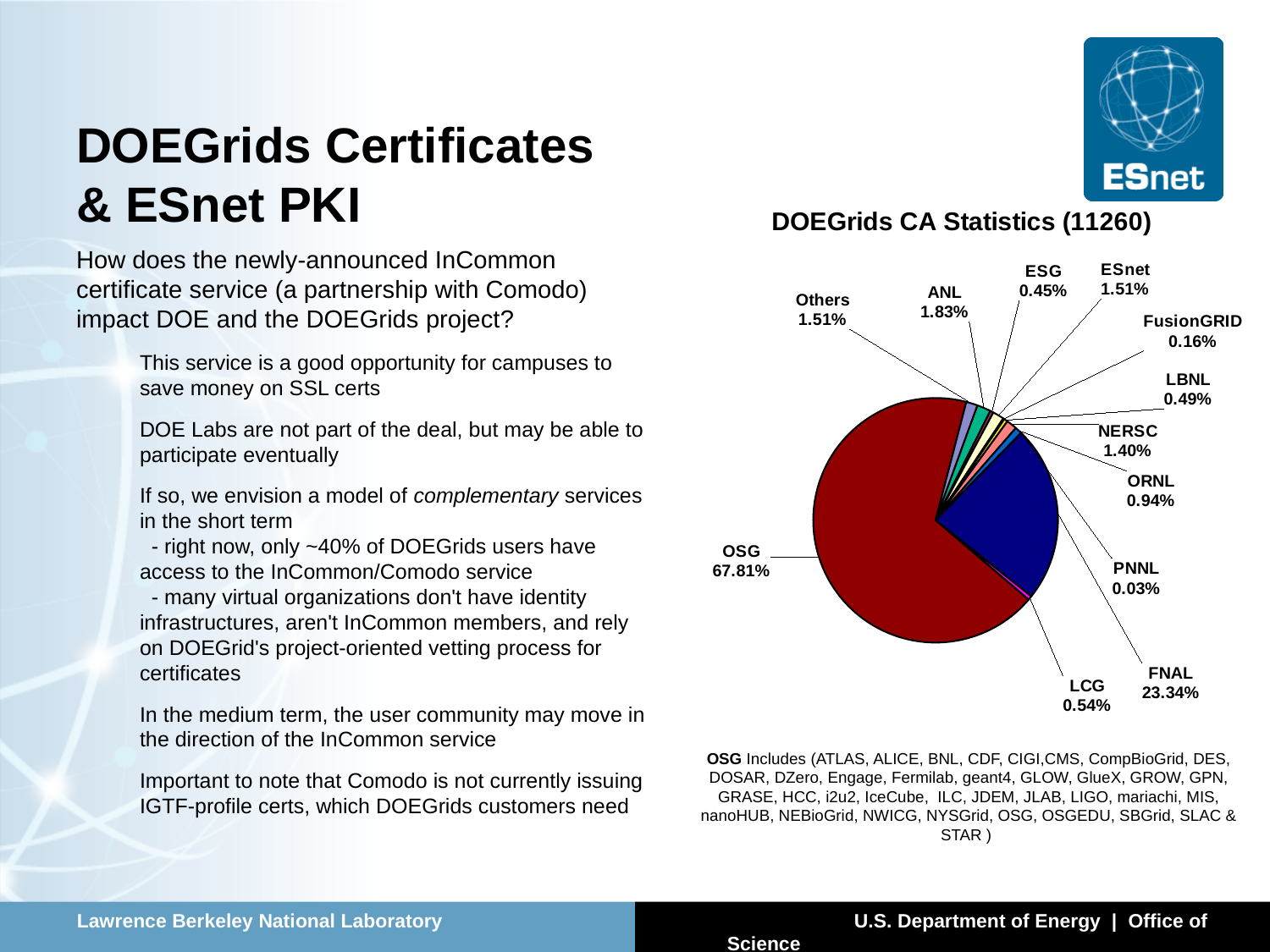
What share of the pie does OSG hold? 67.81% Which category has the largest slice of the pie? OSG What kind of chart is shown on the slide? pie chart What percentage is shown for NERSC? 1.40% What is the combined share of LBNL and ORNL? 1.43% What is the difference between the OSG and FNAL percentages? 44.47% What is the value shown for FNAL? 23.34% What is the title of the chart? DOEGrids CA Statistics (11260) Which category has the smallest slice of the pie? PNNL Which is larger, the share for ANL or the share for ESnet? ANL What is the value shown for FusionGRID? 0.16% How many slices does the pie chart have? 12